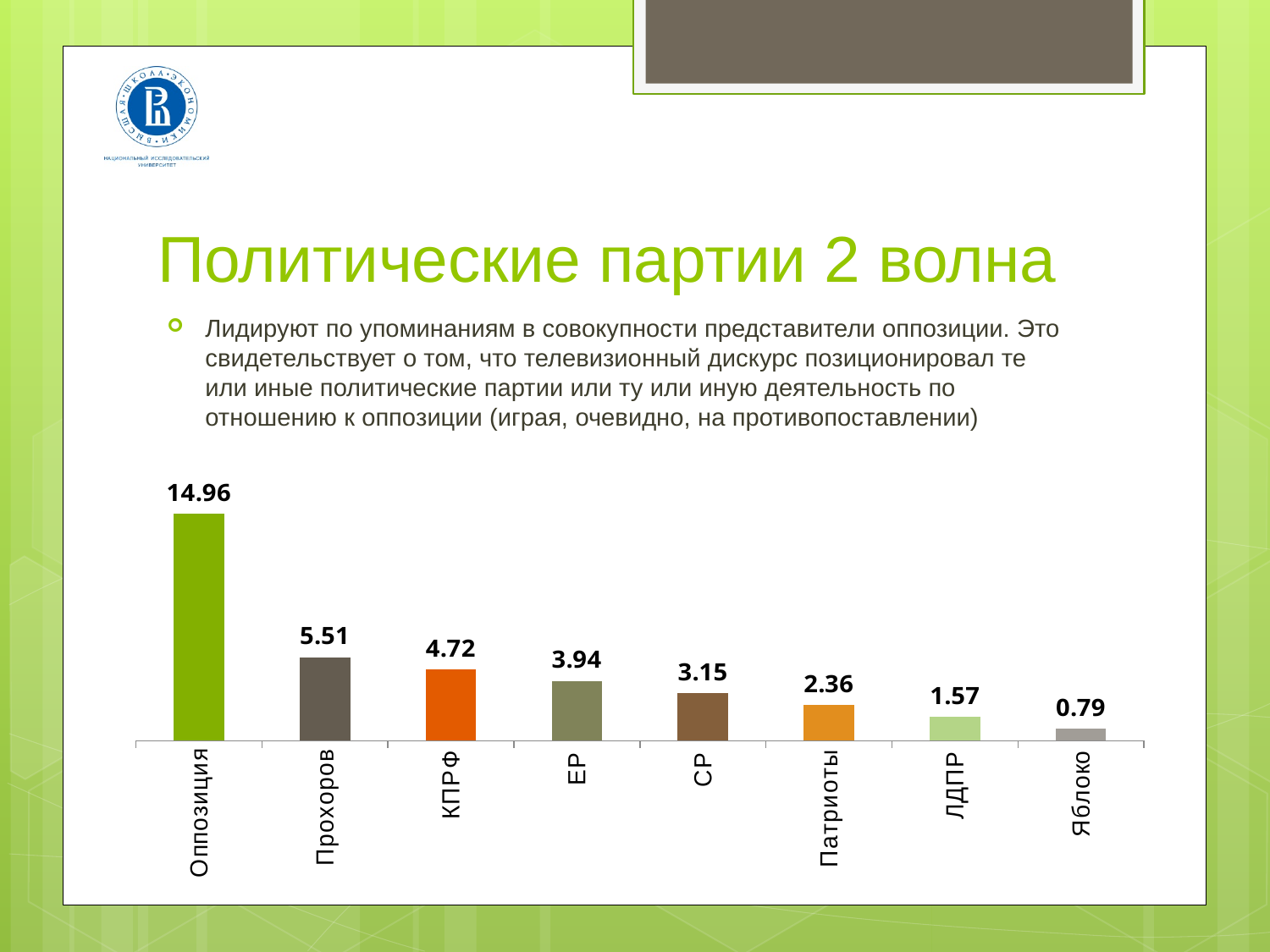
What kind of chart is shown on the slide? bar chart How many categories are shown in the chart? 8 What is the difference between the values for Прохоров and ЕР? 1.57 What is the value for КПРФ? 4.72 What is the value for Оппозиция? 14.96 Which category has the lowest value? Яблоко Which is larger, the value for СР or the value for ЛДПР? СР What colour is the bar for КПРФ? orange-red Which category has the highest value? Оппозиция Do the values rise or fall from left to right along the x axis? fall What is the value for Патриоты? 2.36 What is the difference between the values for Оппозиция and Яблоко? 14.17